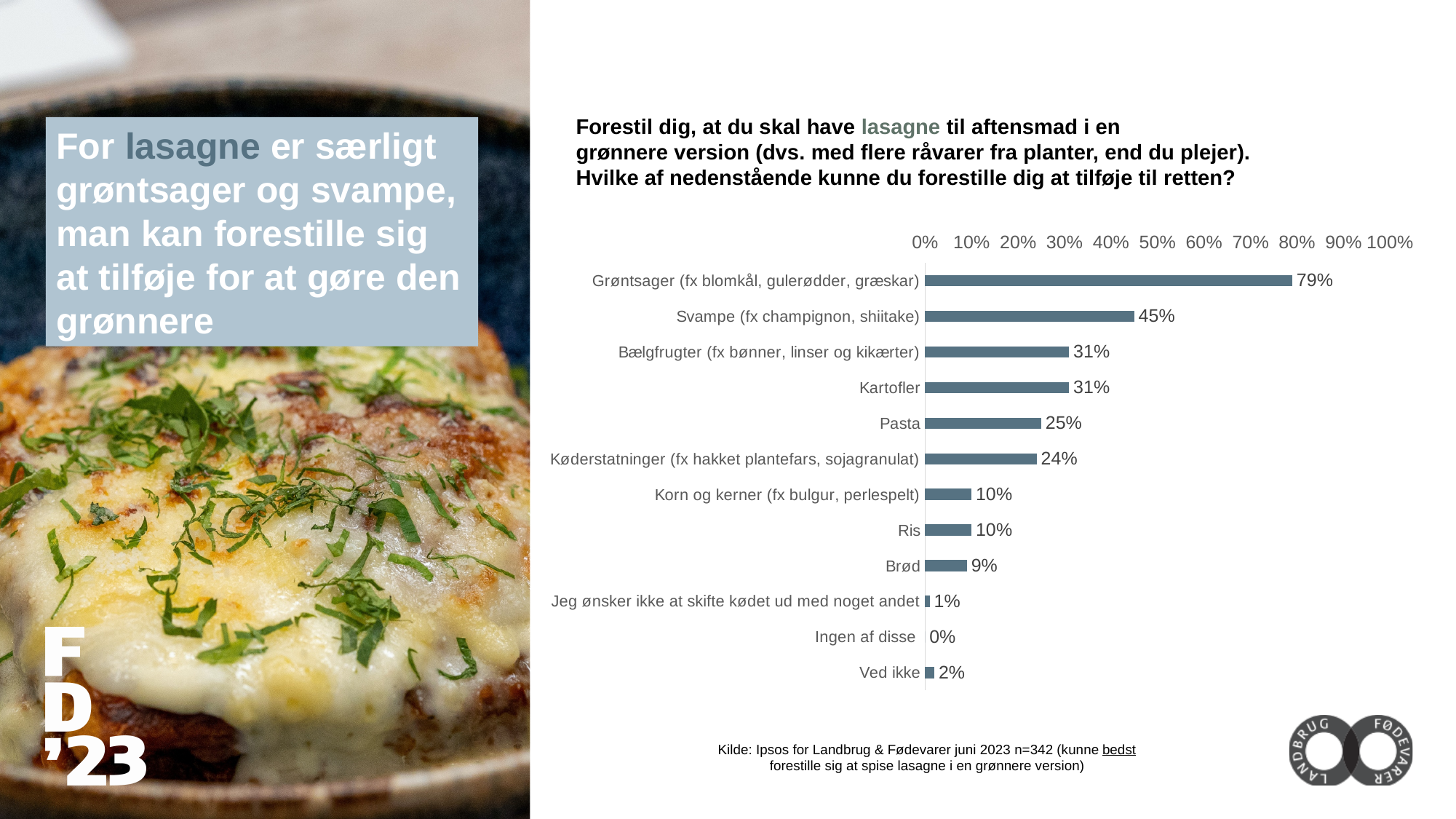
What is the highest value shown on the percentage axis of the chart? 100% What kind of chart is shown on the slide? Bar chart Which category has the highest value in the chart? Grøntsager (fx blomkål, gulerødder, græskar) What percentage of respondents said they could imagine adding Grøntsager (fx blomkål, gulerødder, græskar) to the lasagne? 79% What is the value shown for Svampe (fx champignon, shiitake)? 45% How many categories are shown in the chart? 12 Which has a larger value, Pasta or Brød? Pasta What is the value shown for Køderstatninger (fx hakket plantefars, sojagranulat)? 24% Which category has the lowest value in the chart? Ingen af disse What is the value shown for Ved ikke? 2% What is the difference between the values for Grøntsager and Svampe? 34 percentage points What is the difference between the values for Kartofler and Ris? 21 percentage points